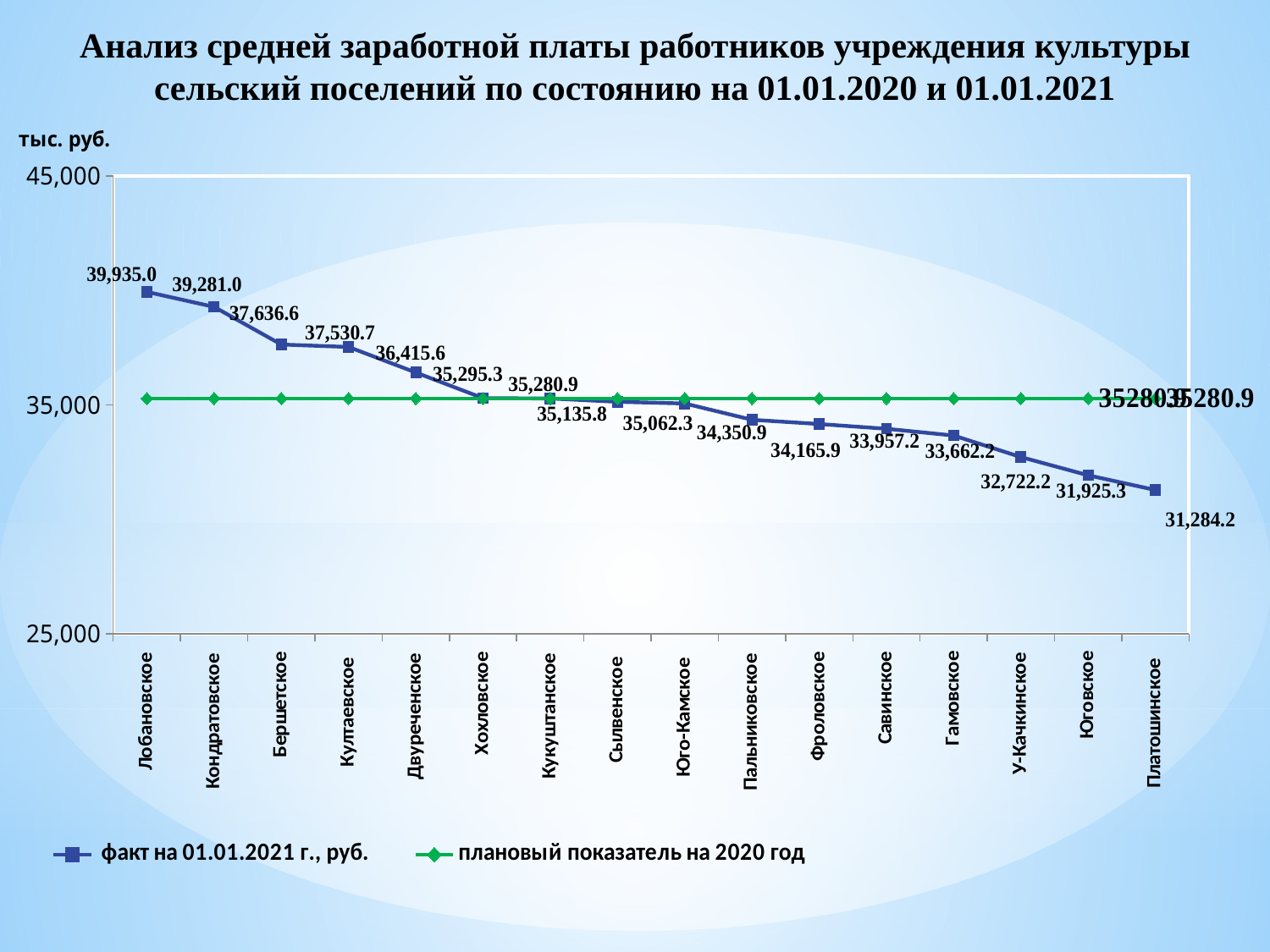
How many series does the legend list? 2 Do the values of the series 'факт на 01.01.2021 г., руб.' rise or fall from left to right along the x axis? fall Which settlement has the highest value in the series 'факт на 01.01.2021 г., руб.'? Лобановское What is the difference between the values for Лобановское and Кондратовское in the series 'факт на 01.01.2021 г., руб.'? 654.0 Which settlement has the lowest value in the series 'факт на 01.01.2021 г., руб.'? Платошинское What unit is indicated above the vertical axis? тыс. руб. What type of chart is shown on the slide? line chart What is the value for Платошинское in the series 'факт на 01.01.2021 г., руб.'? 31,284.2 What is the value for Лобановское in the series 'факт на 01.01.2021 г., руб.'? 39,935.0 Which is larger in the series 'факт на 01.01.2021 г., руб.': Савинское or Гамовское? Савинское What is the value for Двуреченское in the series 'факт на 01.01.2021 г., руб.'? 36,415.6 How many settlements are plotted along the x axis? 16